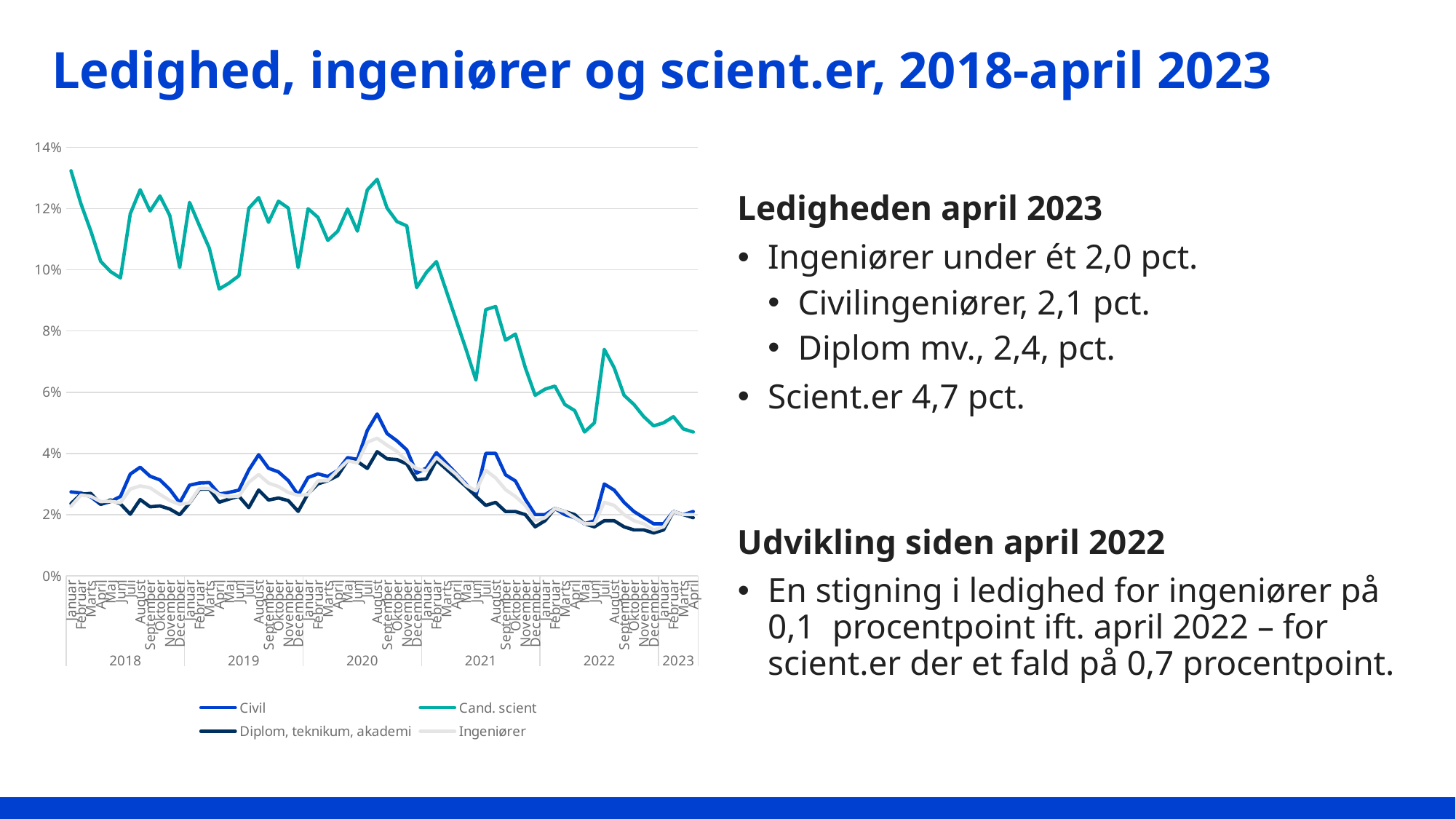
What is the highest tick value shown on the y axis? 14% Which series has the highest values across the whole period? Cand. scient Is the value for Civil in April 2023 greater or less than 4%? less How many year groups are shown on the x axis? 6 Is the value for Cand. scient in April 2023 greater or less than 6%? less Is the value for Cand. scient in August 2020 greater or less than 12%? greater How many series does the chart legend list? 4 What kind of chart is shown on the slide? line chart What colour is the Cand. scient line in the legend? teal Does the Cand. scient line rise or fall from 2020 to 2023? fall